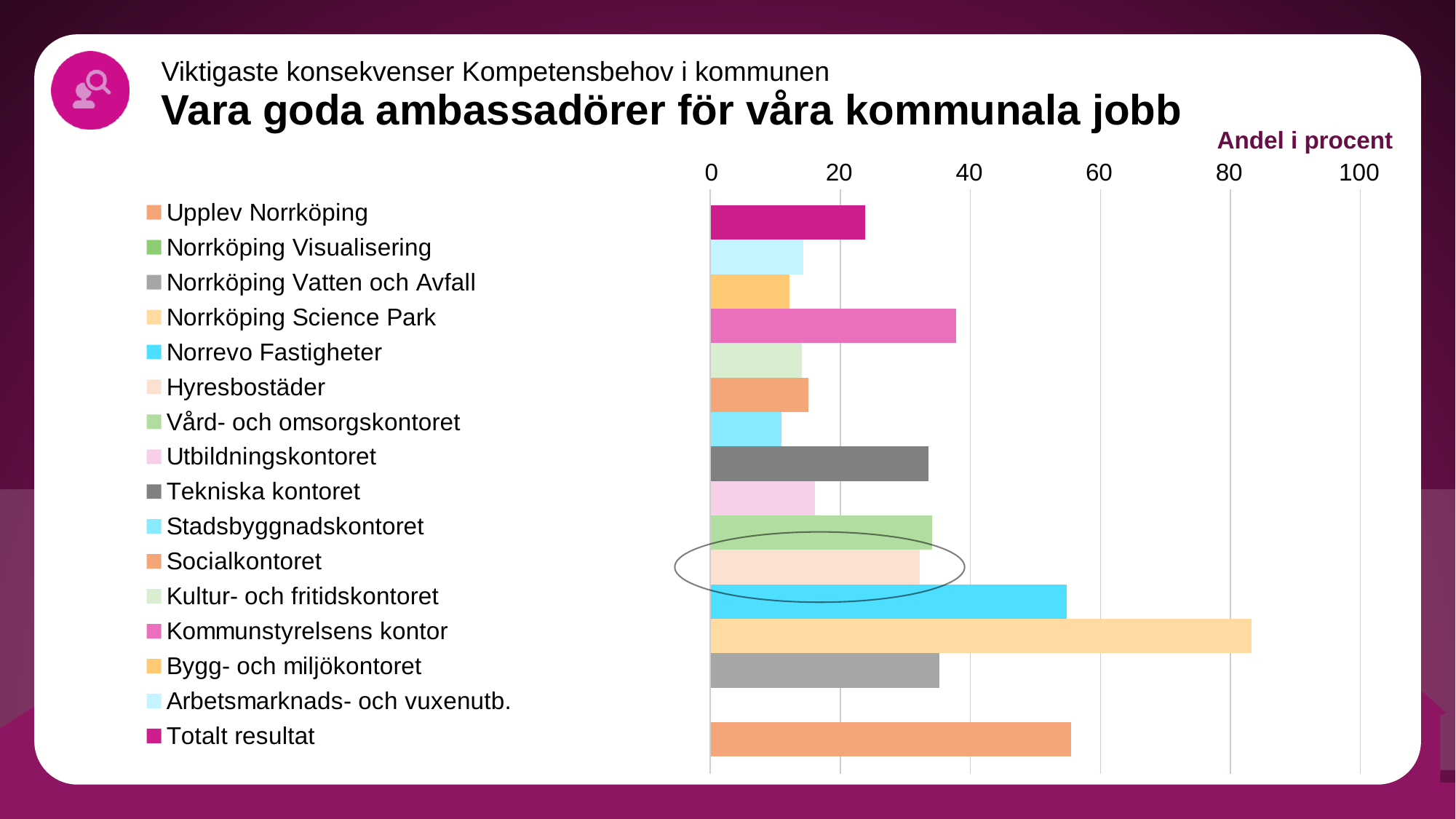
How many entries does the chart legend list? 16 Which is larger, the value for Kommunstyrelsens kontor or the value for Totalt resultat? Kommunstyrelsens kontor Which is larger, the value for Norrköping Science Park or the value for Norrevo Fastigheter? Norrköping Science Park What label is shown above the chart's horizontal axis? Andel i procent Which legend entry has the highest value in the chart? Norrköping Science Park Is the value for Upplev Norrköping greater or less than 60? less Is the value for Hyresbostäder greater or less than 20? greater Is the value for Norrköping Science Park greater or less than 80? greater What kind of chart is shown on the slide? bar chart